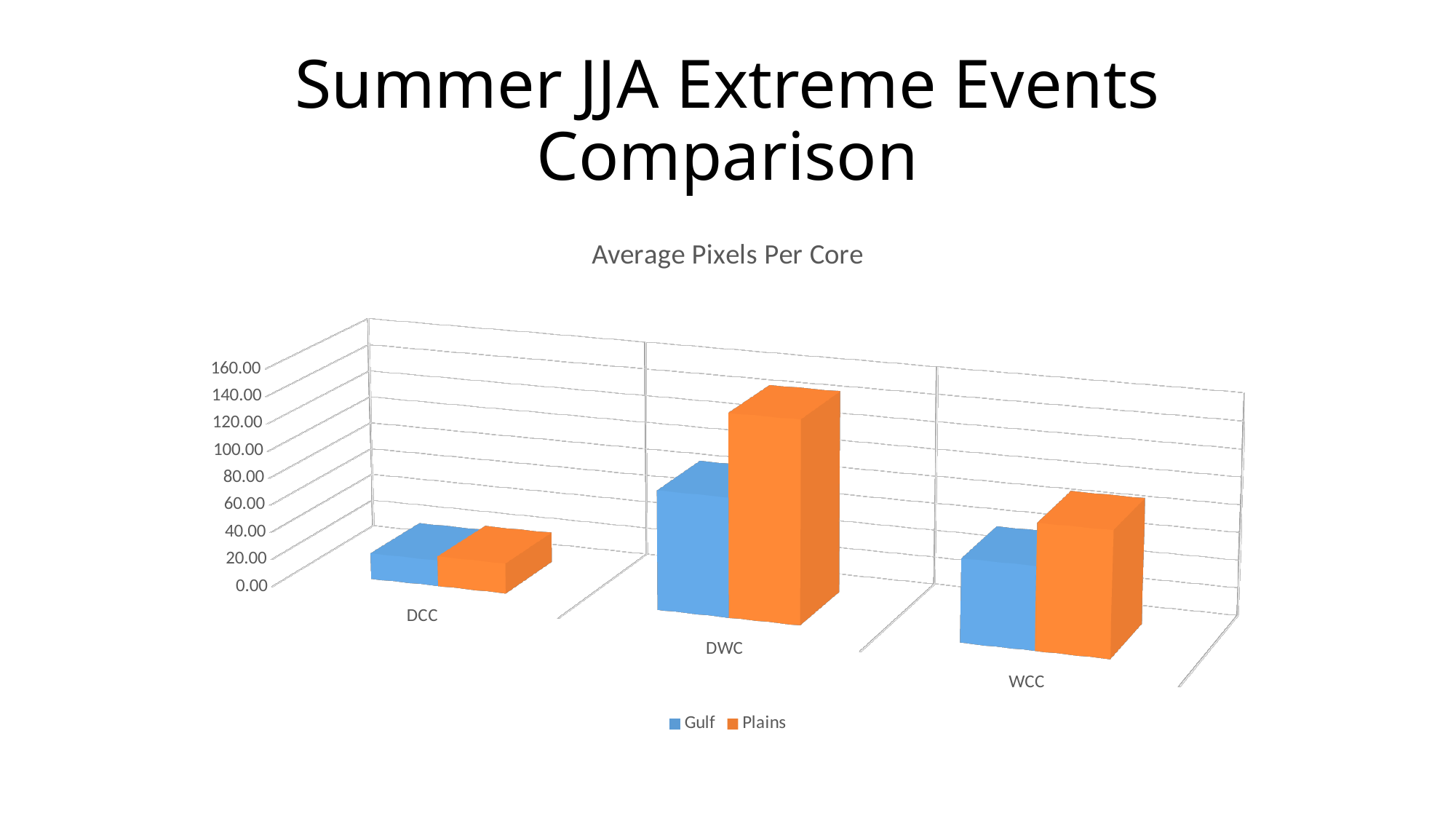
Which category has the highest Plains value? DWC Is the Plains value for DWC greater or less than 100.00? greater How many categories are shown on the x axis? 3 What is the title of the chart? Average Pixels Per Core How many series does the legend list? 2 Which category has the lowest Plains value? DCC For WCC, which series has the larger value, Gulf or Plains? Plains Which category has the lowest Gulf value? DCC For DWC, which series has the larger value, Gulf or Plains? Plains What kind of chart is shown on the slide? bar chart Is the Gulf value for DCC greater or less than 40.00? less Which category has the highest Gulf value? DWC